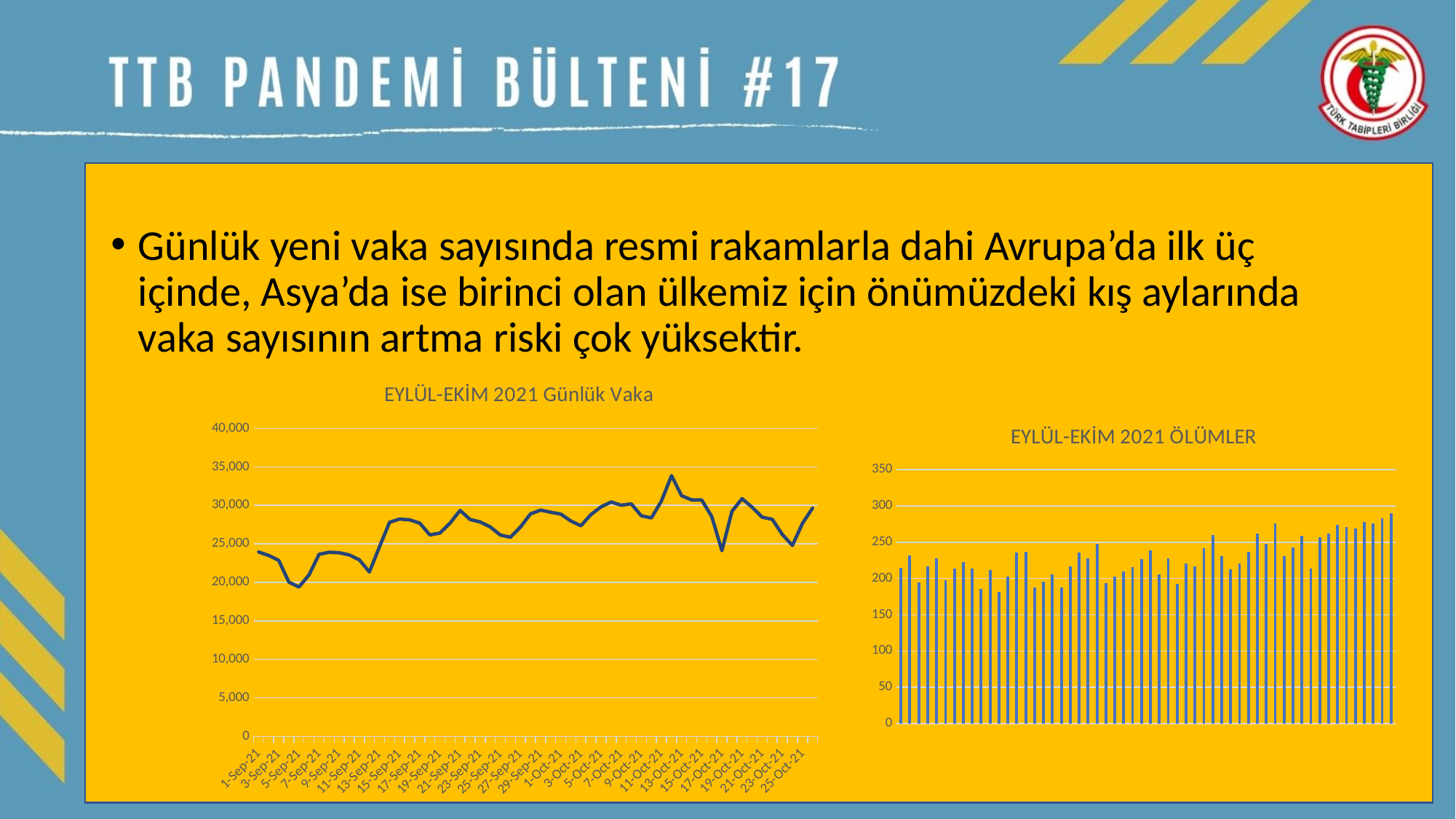
In the 'EYLÜL-EKİM 2021 Günlük Vaka' chart, which is larger, the value for 11-Oct-21 or the value for 5-Sep-21? 11-Oct-21 What kind of chart is the 'EYLÜL-EKİM 2021 Günlük Vaka' chart? line chart In the 'EYLÜL-EKİM 2021 Günlük Vaka' chart, is the value for 5-Sep-21 greater or less than 25,000? less In the 'EYLÜL-EKİM 2021 Günlük Vaka' chart, which labelled date has the lowest value? 5-Sep-21 In the 'EYLÜL-EKİM 2021 Günlük Vaka' chart, is the value for 1-Sep-21 greater or less than 30,000? less In the 'EYLÜL-EKİM 2021 Günlük Vaka' chart, do the values generally rise or fall from 1-Sep-21 to 25-Oct-21? rise What kind of chart is the 'EYLÜL-EKİM 2021 ÖLÜMLER' chart? bar chart In the 'EYLÜL-EKİM 2021 ÖLÜMLER' chart, is the tallest bar greater or less than 250? greater What is the highest value shown on the y axis of the 'EYLÜL-EKİM 2021 ÖLÜMLER' chart? 350 In the 'EYLÜL-EKİM 2021 ÖLÜMLER' chart, do the bar values generally rise or fall from left to right? rise